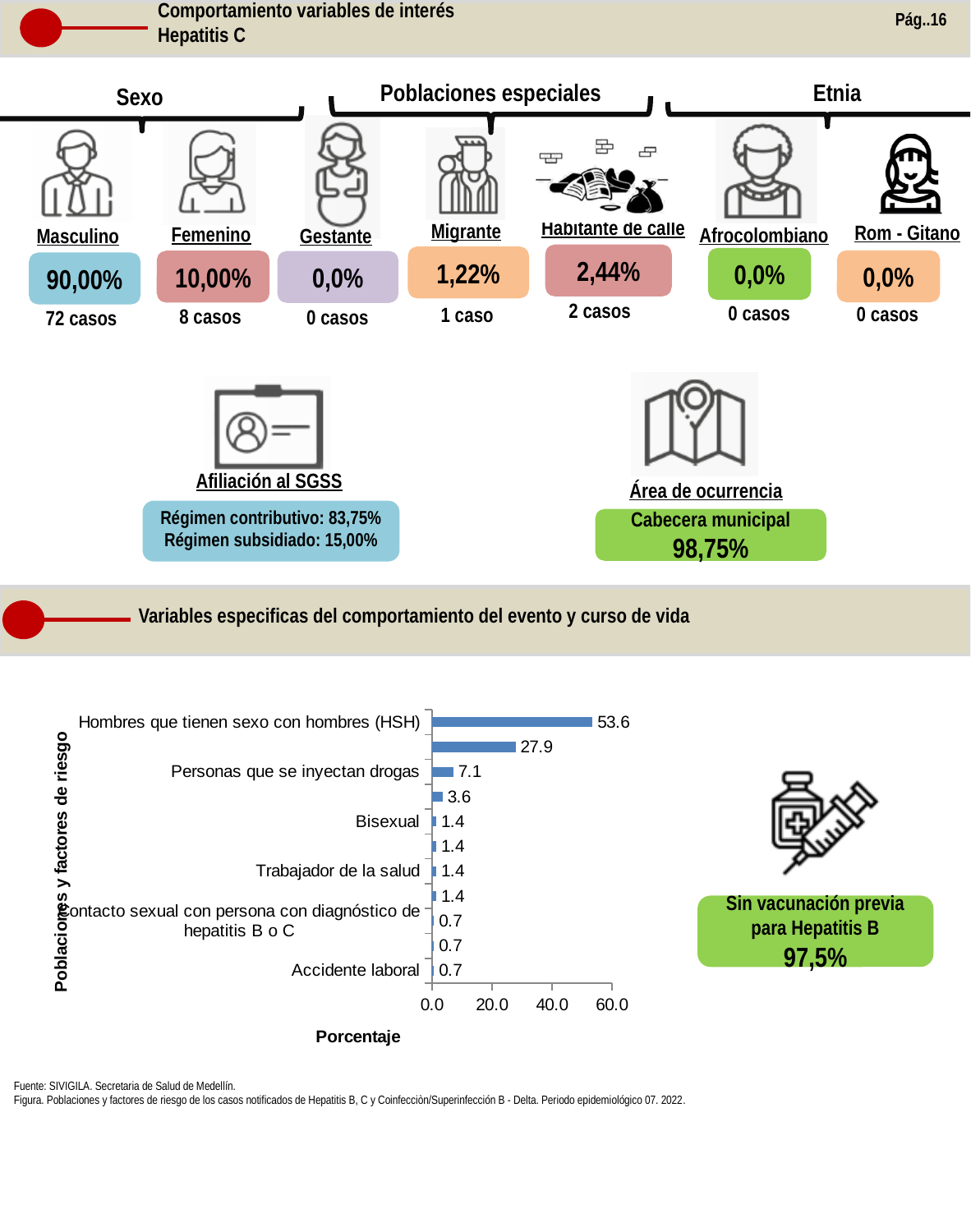
Which is larger in the bar chart: Personas que se inyectan drogas or Accidente laboral? Personas que se inyectan drogas What is the value for Trabajador de la salud in the bar chart? 1.4 What kind of chart is shown at the bottom of the slide? Bar chart What is the value for Personas que se inyectan drogas in the bar chart? 7.1 What is the title of the horizontal axis of the bar chart? Porcentaje Is the value for Hombres que tienen sexo con hombres (HSH) greater or less than 40.0? greater Which category has the highest value in the bar chart? Hombres que tienen sexo con hombres (HSH) What is the value for Bisexual in the bar chart? 1.4 What is the value for Accidente laboral in the bar chart? 0.7 What is the value for Hombres que tienen sexo con hombres (HSH) in the bar chart? 53.6 What is the difference between the values for Hombres que tienen sexo con hombres (HSH) and Personas que se inyectan drogas? 46.5 How many bars are plotted in the chart? 11